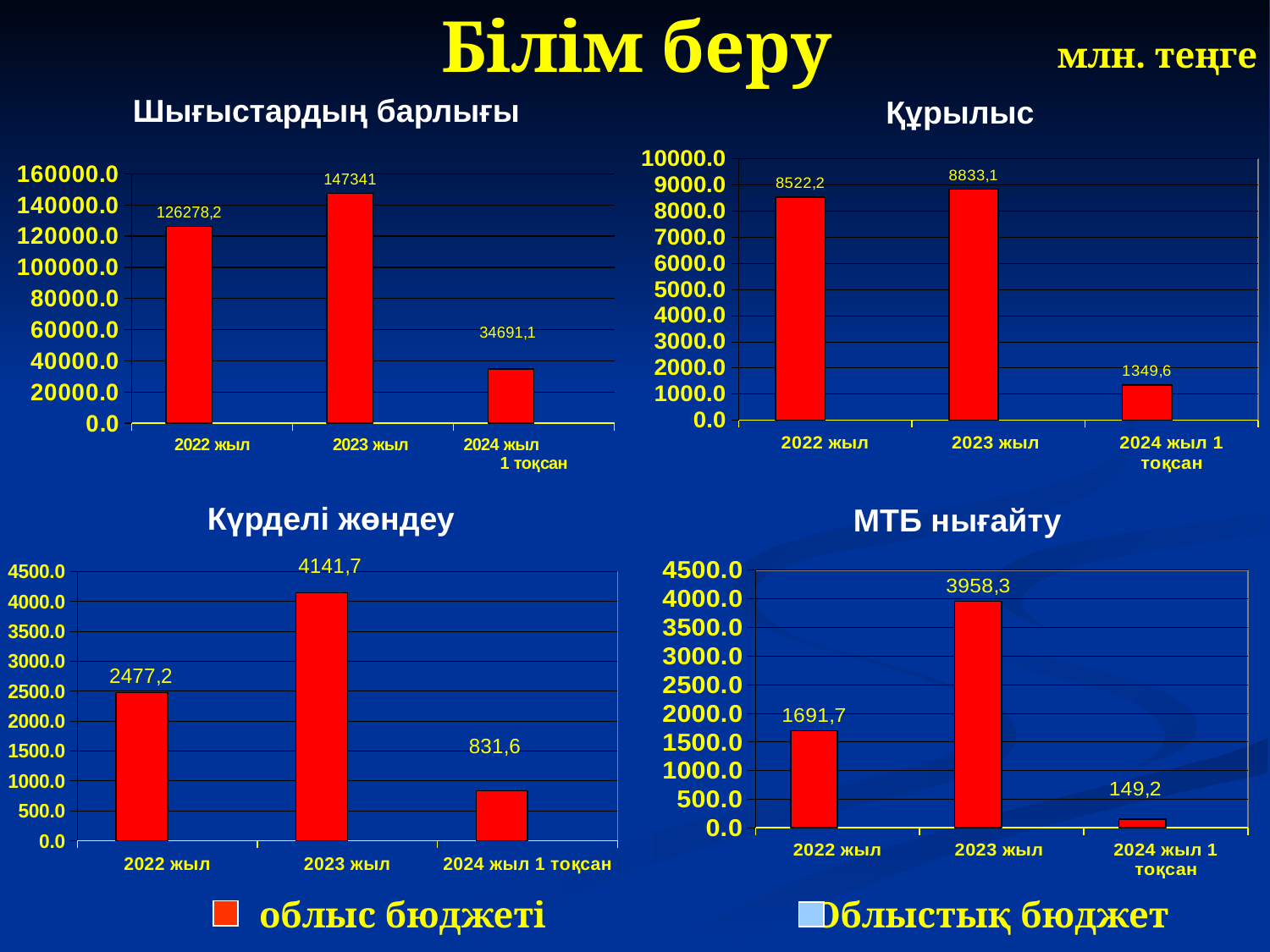
What kind of chart is the 'МТБ нығайту' chart? bar chart In the 'Құрылыс' chart, which category has the highest value? 2023 жыл In the 'Күрделі жөндеу' chart, what is the value for 2022 жыл? 2477,2 In the 'Құрылыс' chart, what is the value for 2024 жыл 1 тоқсан? 1349,6 In the 'МТБ нығайту' chart, what is the value for 2023 жыл? 3958,3 In the 'Шығыстардың барлығы' chart, is the value for 2022 жыл greater or less than 120000.0? greater In the 'Шығыстардың барлығы' chart, which category has the lowest value? 2024 жыл 1 тоқсан How many charts are shown on the slide? 4 How many categories are shown in the 'Күрделі жөндеу' chart? 3 In the 'Күрделі жөндеу' chart, what is the difference between the values for 2023 жыл and 2022 жыл? 1664,5 In the 'Шығыстардың барлығы' chart, what is the value for 2023 жыл? 147341 In the 'МТБ нығайту' chart, which is larger: the value for 2022 жыл or the value for 2024 жыл 1 тоқсан? 2022 жыл